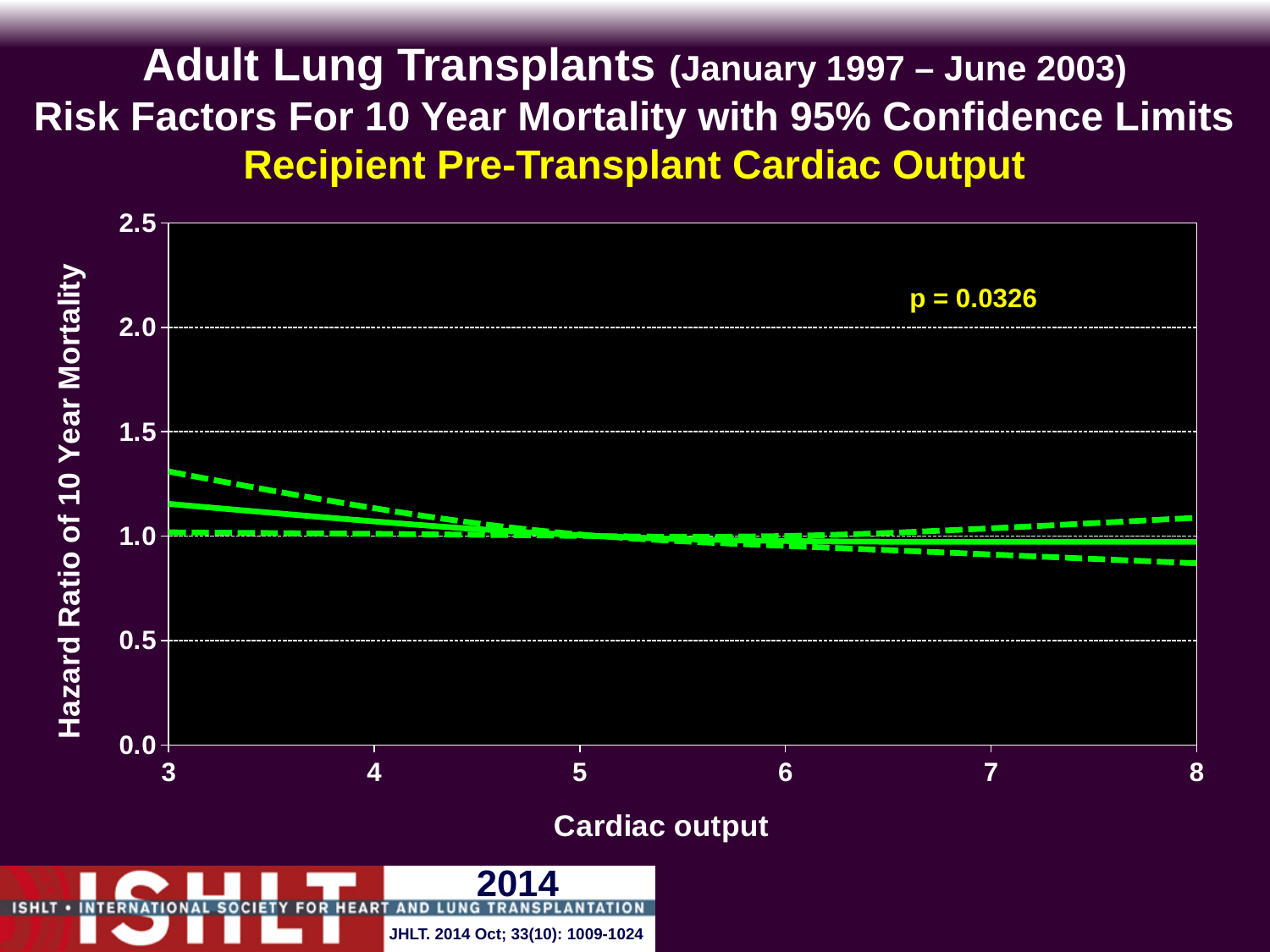
How many lines are plotted on the chart? 3 What is the label of the x axis? Cardiac output Does the solid hazard ratio line rise or fall as cardiac output increases from 3 to 8? fall Is the hazard ratio on the solid line at a cardiac output of 4 greater or less than 1.5? less What p-value is shown on the chart? p = 0.0326 Is the lower confidence limit at a cardiac output of 8 greater or less than 1.0? less What kind of chart is shown on the slide? line chart Is the hazard ratio on the solid line at a cardiac output of 3 greater or less than 1.0? greater